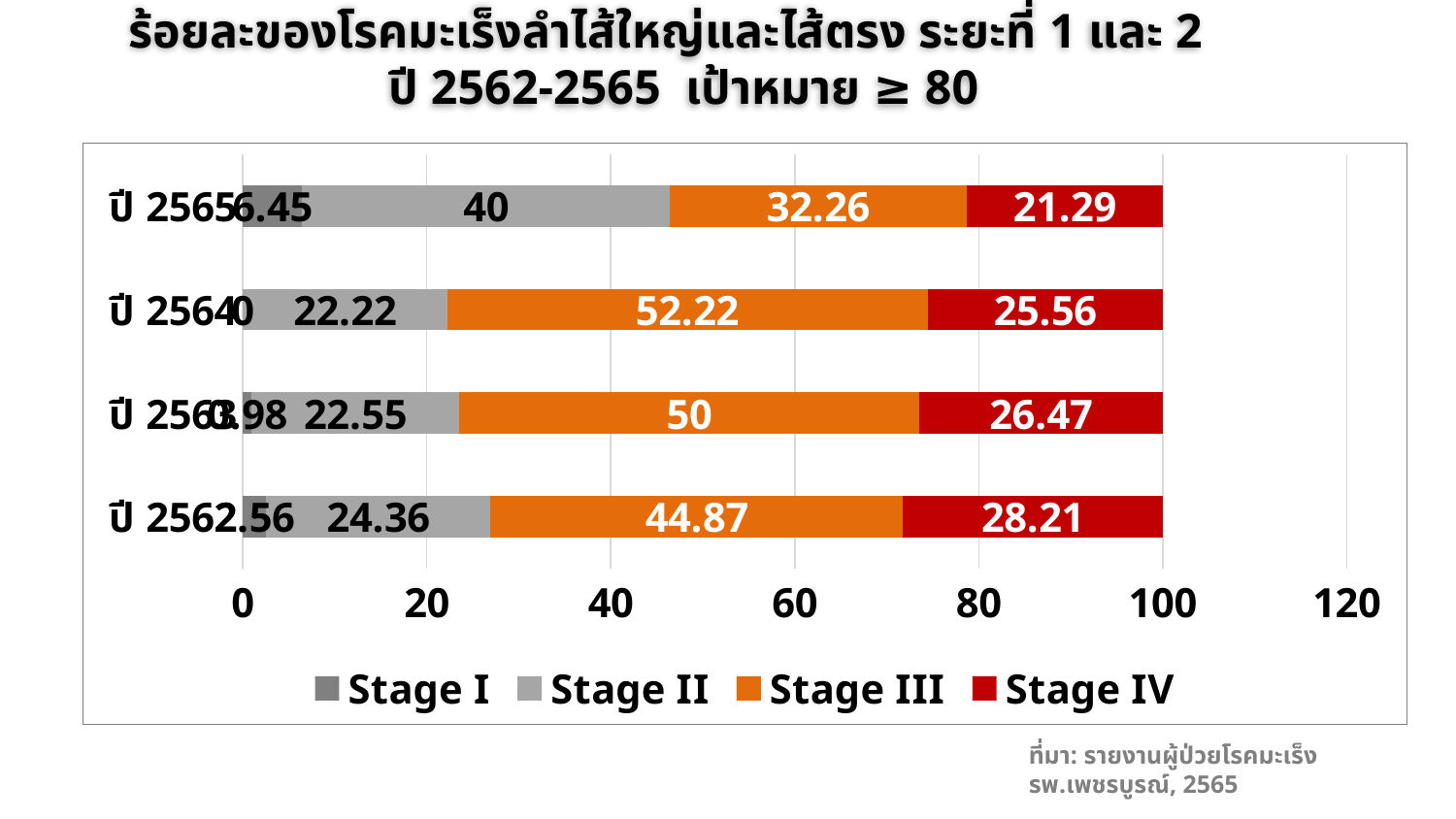
How many series does the legend list? 4 Which year has the highest Stage IV value? ปี 2562 What kind of chart is shown on the slide? Stacked bar chart Which is larger, the Stage III value for ปี 2563 or for ปี 2562? ปี 2563 Does the Stage IV value rise or fall from ปี 2562 to ปี 2565? Fall How many years (categories) are plotted on the chart? 4 What is the difference between the Stage IV value for ปี 2562 and for ปี 2565? 6.92 What is the Stage III value for ปี 2564? 52.22 What is the total of the stacked bar for ปี 2565? 100 What is the Stage II value for ปี 2565? 40 Which year has the lowest Stage III value? ปี 2565 What is the Stage IV value for ปี 2562? 28.21